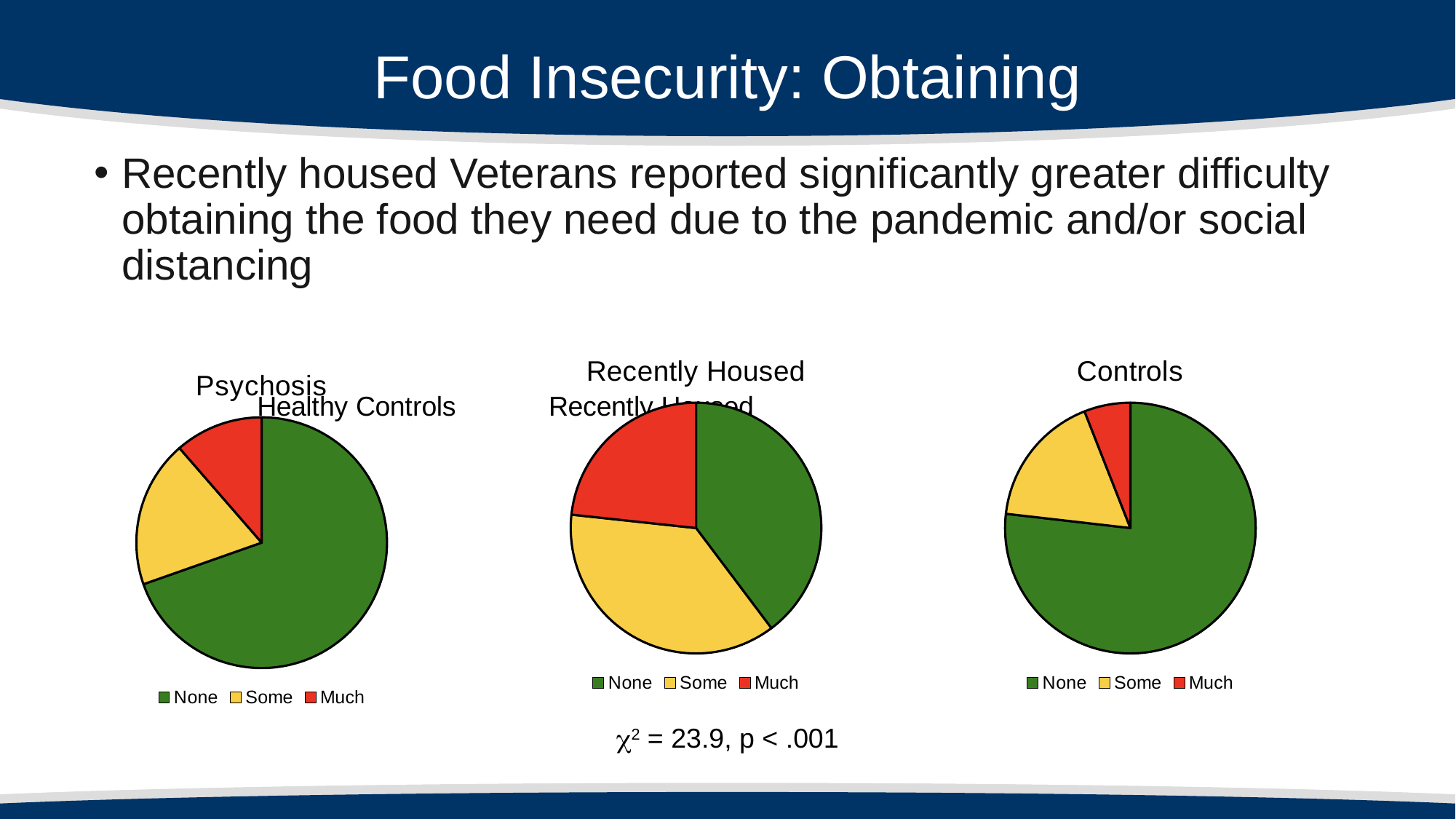
In the Controls pie chart, what colour represents the Some category? Yellow In the Recently Housed pie chart, which category has the smallest slice? Much Is the Much slice larger in the Recently Housed pie chart or in the Controls pie chart? Recently Housed What is the title of the rightmost pie chart? Controls In the left pie chart, which category has the largest slice? None What kind of chart is used for the Controls data on this slide? Pie chart Is the None slice larger in the Controls pie chart or in the Recently Housed pie chart? Controls In the Recently Housed pie chart, how many categories does the legend list? 3 How many pie charts are shown on the slide? 3 In the left pie chart, which category has the smallest slice? Much In the Controls pie chart, which category has the largest slice? None In the Controls pie chart, which category has the smallest slice? Much